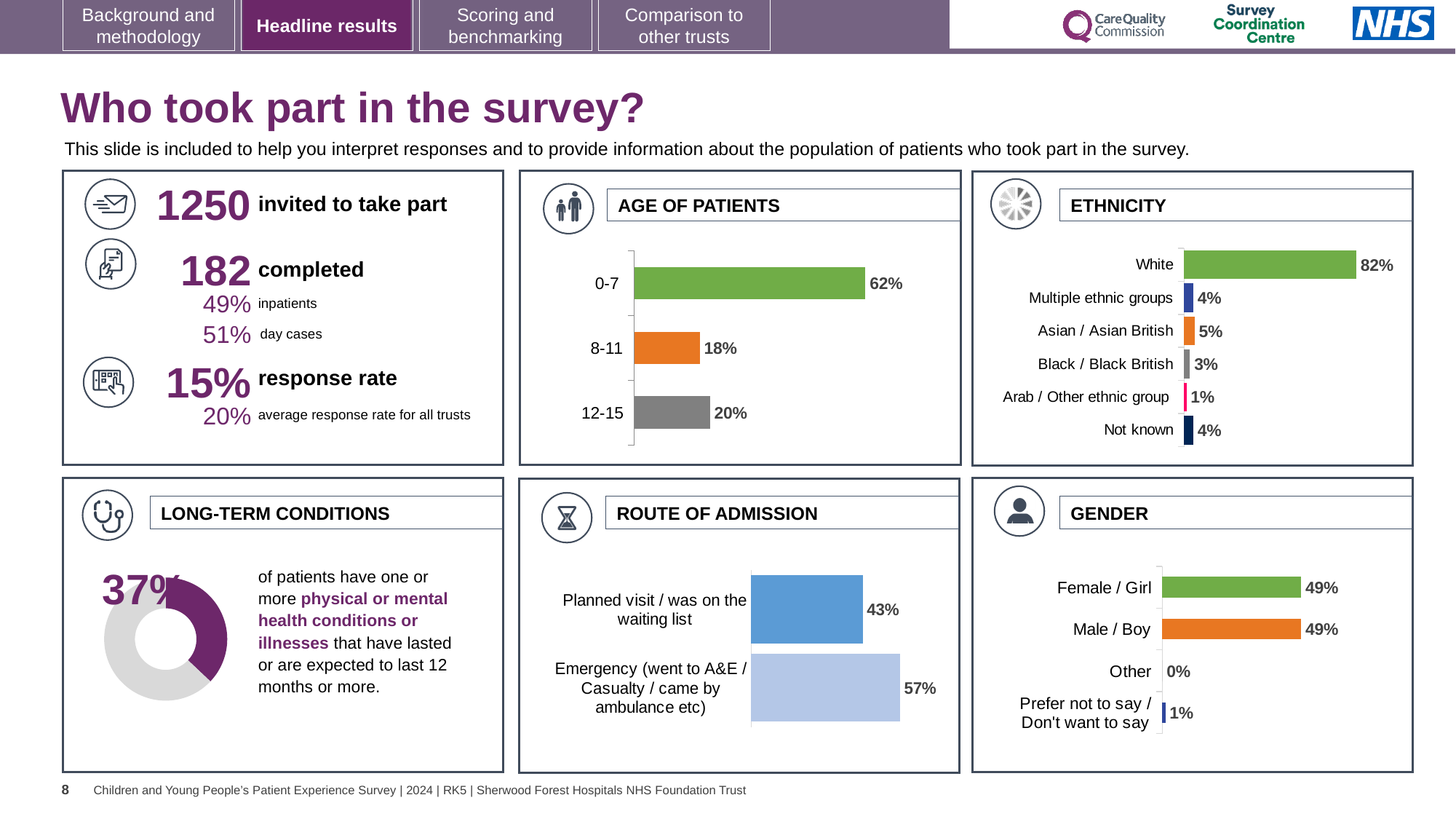
In the ETHNICITY chart, how many ethnicity categories are shown? 6 In the GENDER chart, what percentage is shown for Other? 0% In the ETHNICITY chart, which is larger, Asian / Asian British or Black / Black British? Asian / Asian British In the AGE OF PATIENTS chart, what percentage of patients are aged 0-7? 62% In the GENDER chart, what percentage of patients are Male / Boy? 49% In the ROUTE OF ADMISSION chart, what is the difference between the Emergency and Planned visit percentages? 14% What kind of chart is used in the LONG-TERM CONDITIONS panel? Donut chart In the ETHNICITY chart, what percentage is shown for Arab / Other ethnic group? 1% In the AGE OF PATIENTS chart, which age group has the lowest percentage? 8-11 In the ETHNICITY chart, what percentage of patients are White? 82% In the AGE OF PATIENTS chart, what is the difference between the 12-15 and 8-11 percentages? 2% In the ROUTE OF ADMISSION chart, what percentage of patients came via Emergency (went to A&E / Casualty / came by ambulance etc)? 57%